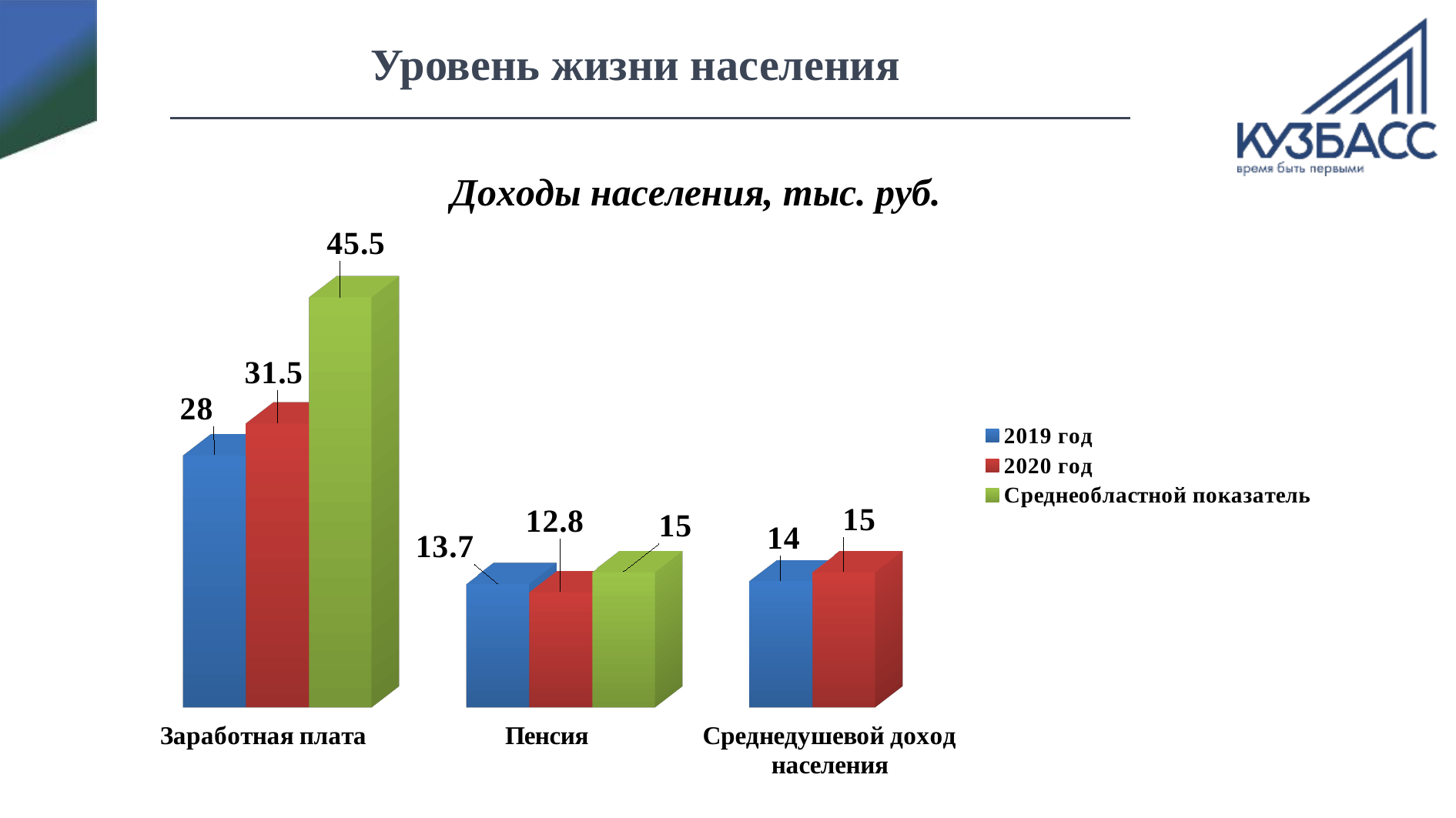
What is the value for 2020 год for Пенсия? 12.8 How many categories are shown on the x axis? 3 Which category has the highest value for 2020 год? Заработная плата How many series does the legend list? 3 What is the value for 2019 год for Заработная плата? 28 Which category has the lowest value for 2019 год? Пенсия What is the Среднеобластной показатель value for Заработная плата? 45.5 What is the difference between the 2020 год and 2019 год values for Заработная плата? 3.5 What is the value for 2020 год for Среднедушевой доход населения? 15 What is the title of the chart? Доходы населения, тыс. руб. What kind of chart is shown on the slide? Bar chart Which is larger for Пенсия: the 2019 год value or the 2020 год value? 2019 год